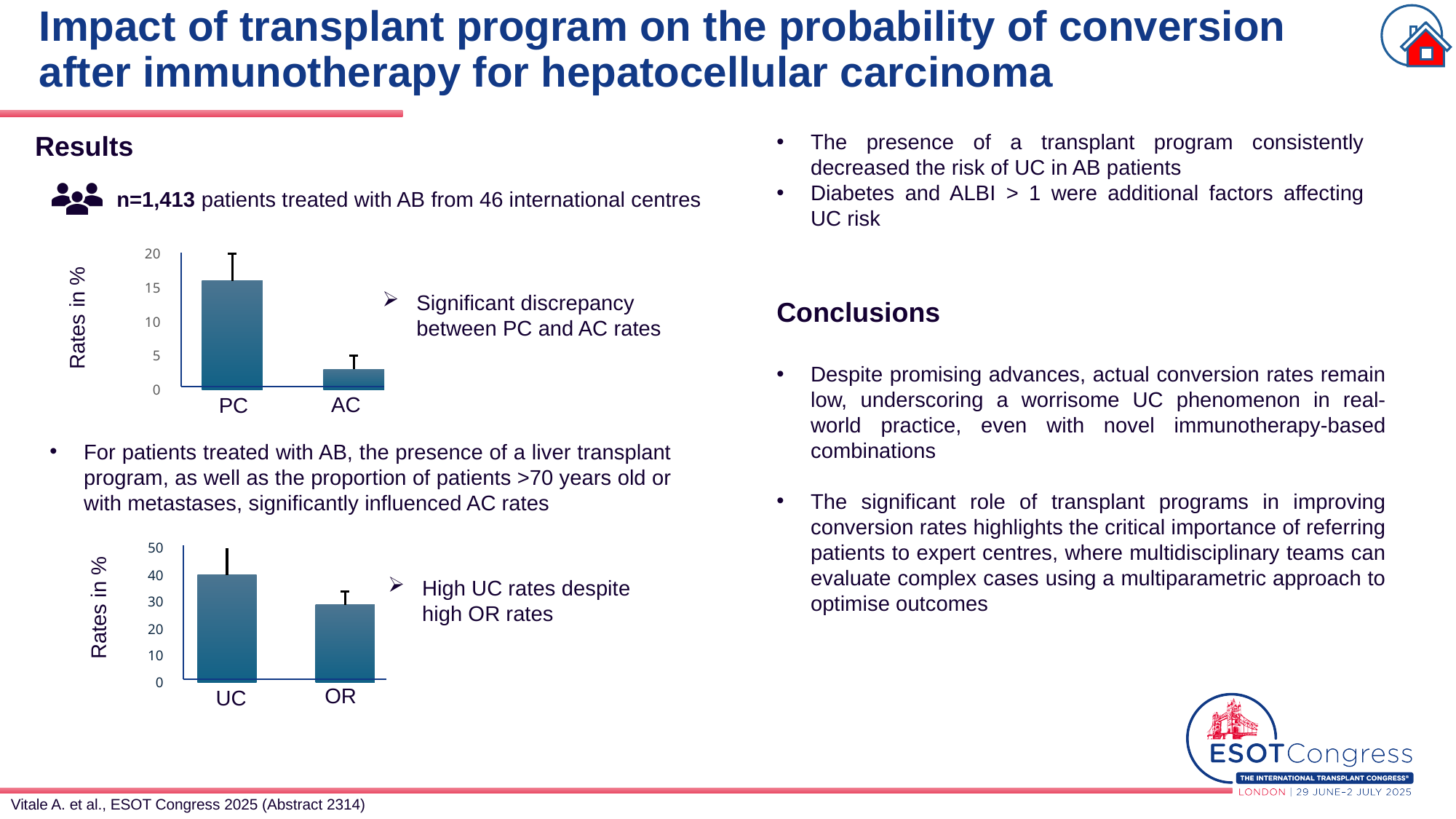
In the top chart (PC vs AC), what is the label on the y axis? Rates in % In the top chart (PC vs AC), which category has the lowest rate? AC In the bottom chart (UC vs OR), which category has the higher rate? UC In the bottom chart (UC vs OR), what kind of chart is shown? bar chart In the top chart (PC vs AC), is the value for PC greater or less than 10? greater In the top chart (PC vs AC), is the value for AC greater or less than 5? less In the top chart (PC vs AC), which category has the higher rate? PC In the bottom chart (UC vs OR), is the value for OR greater or less than 40? less In the top chart (PC vs AC), what kind of chart is shown? bar chart In the top chart (PC vs AC), how many categories are plotted? 2 In the bottom chart (UC vs OR), which is larger, the value for OR or the value for UC? UC